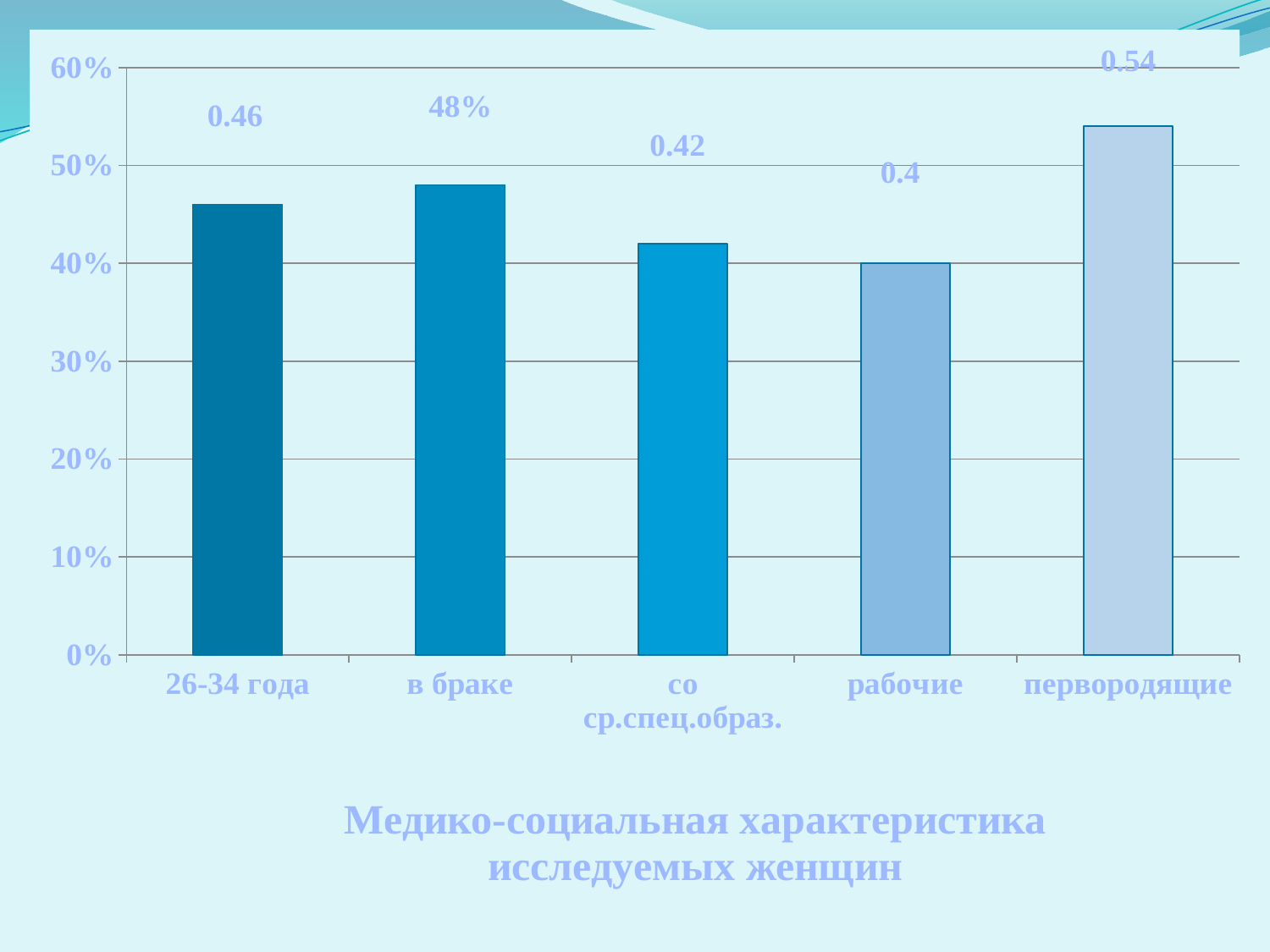
Which category has the lowest bar? рабочие What is the value shown for "рабочие"? 0.4 What is the value shown for the category "26-34 года"? 0.46 What is the value shown for "со ср.спец.образ."? 0.42 What is the data label shown above the bar for "в браке"? 48% Which is larger, the bar for "26-34 года" or the bar for "со ср.спец.образ."? 26-34 года What is the value shown for "первородящие"? 0.54 How many categories are shown on the x axis? 5 What is the difference between the values for "первородящие" and "рабочие"? 0.14 What is the title of the chart? Медико-социальная характеристика исследуемых женщин Is the bar for "первородящие" greater or less than 50%? greater Which category has the highest bar? первородящие